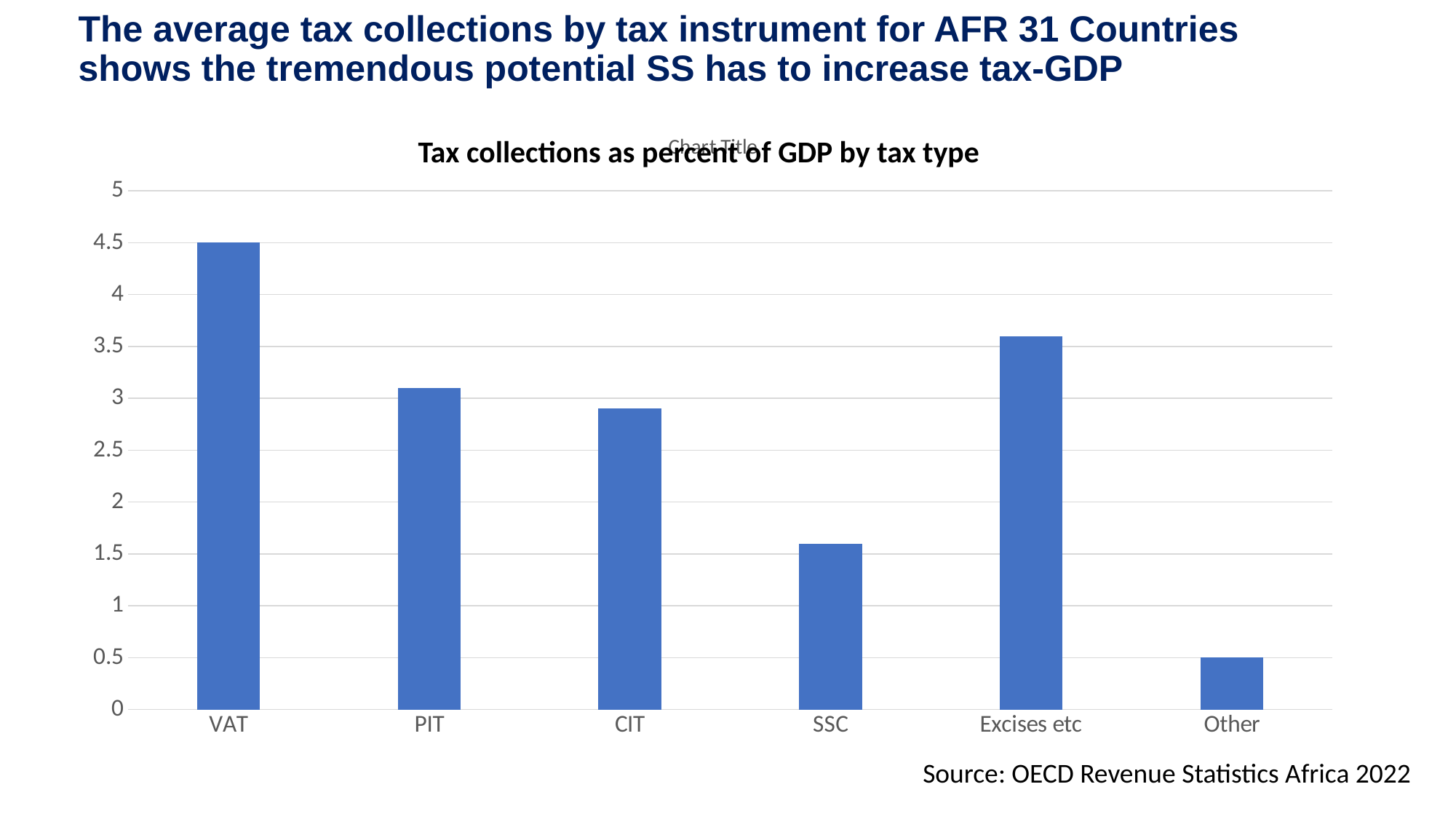
Which is larger, the value for Excises etc or the value for SSC? Excises etc What kind of chart is shown on the slide? bar chart Which tax type has the highest tax collection as percent of GDP? VAT Is the value for PIT greater or less than 3? greater What is the value for VAT? 4.5 What is the title of the chart? Tax collections as percent of GDP by tax type Is the value for CIT greater or less than 3? less What is the value for Other? 0.5 Is the value for Excises etc greater or less than 3.5? greater Which tax type has the lowest tax collection as percent of GDP? Other How many tax types are shown on the x axis of the chart? 6